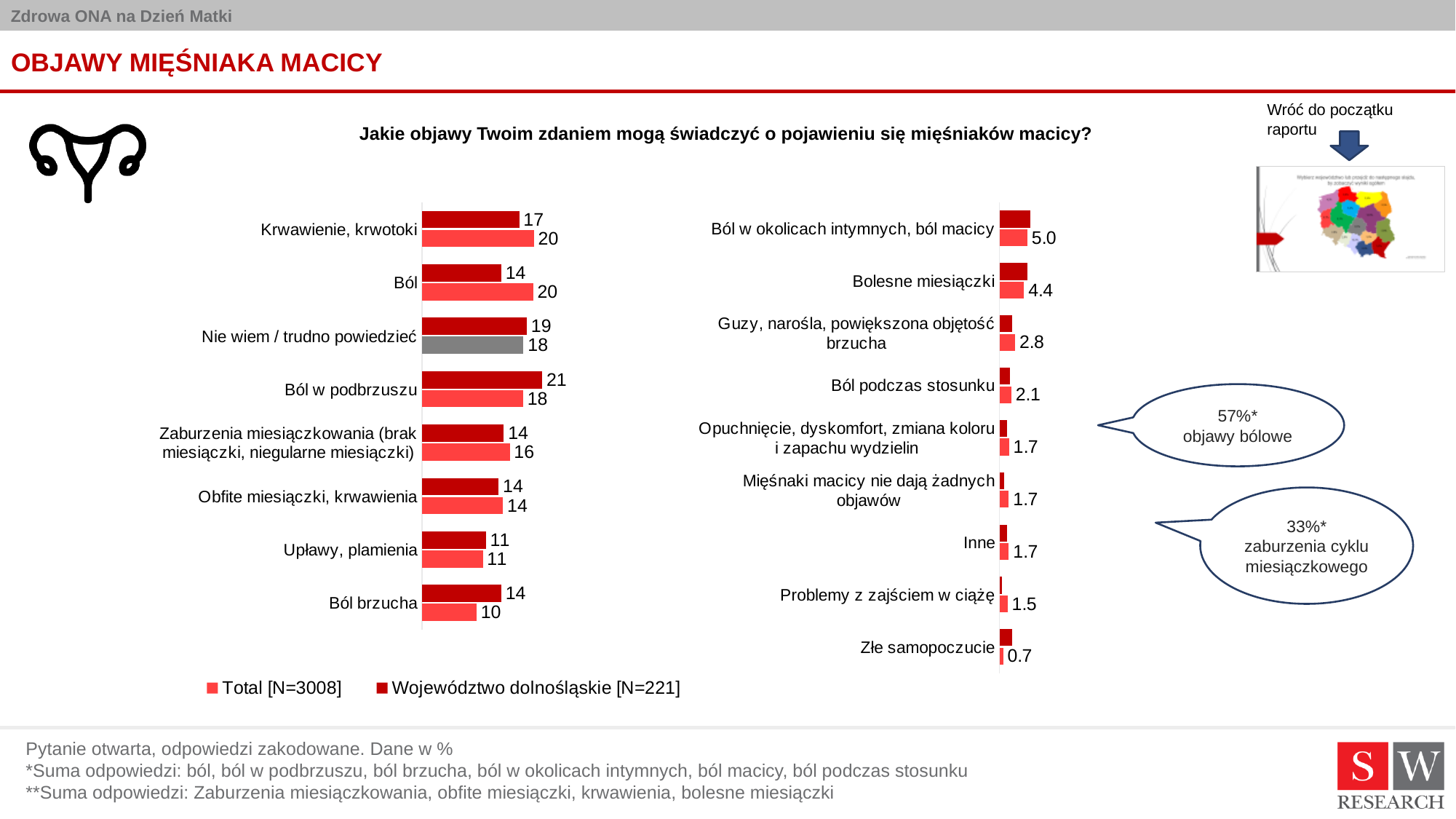
In the right chart, what is the Total [N=3008] value for Ból w okolicach intymnych, ból macicy? 5.0 In the left chart, what is the difference between the Total and Województwo dolnośląskie values for Ból? 6 In the right chart, what is the Total [N=3008] value for Złe samopoczucie? 0.7 In the left chart, which category has the highest Województwo dolnośląskie [N=221] value? Ból w podbrzuszu In the left chart, which category has the lowest Total [N=3008] value? Ból brzucha In the left chart, what is the Total [N=3008] value for Krwawienie, krwotoki? 20 How many categories are shown in the right chart? 9 What type of chart is used on the slide? Bar chart In the left chart, which is larger for Ból brzucha: the Total value or the Województwo dolnośląskie value? Województwo dolnośląskie How many series does the legend list? 2 In the left chart, what is the Województwo dolnośląskie [N=221] value for Ból w podbrzuszu? 21 In the left chart, what is the Total [N=3008] value for Ból brzucha? 10